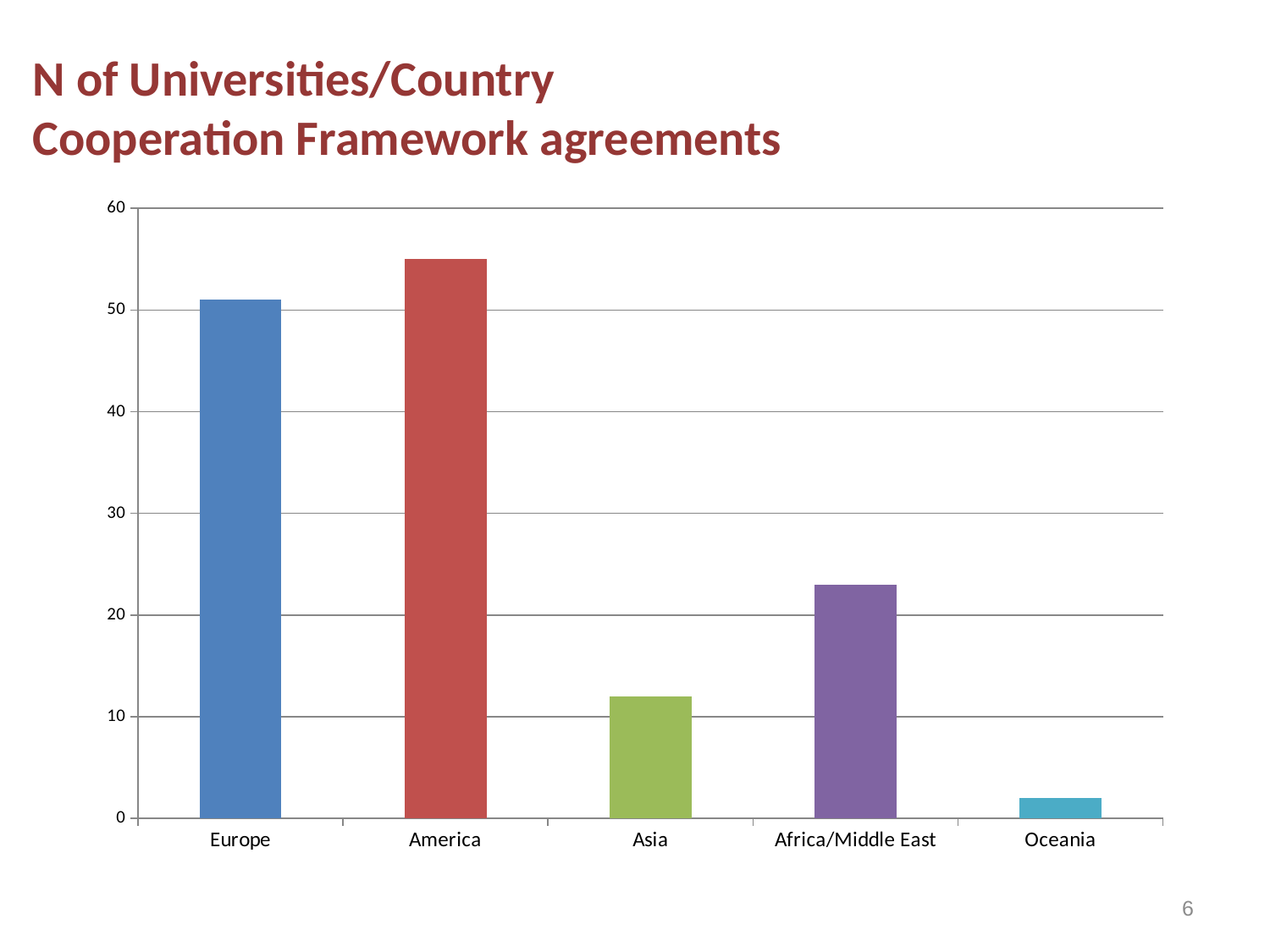
What is the maximum value shown on the y axis of the chart? 60 Which is larger, the value for Asia or the value for Africa/Middle East? Africa/Middle East Is the value for Africa/Middle East greater or less than 20? greater Is the value for Asia greater or less than 20? less How many categories are shown on the x axis of the chart? 5 Is the value for America greater or less than 50? greater Which category has the lowest bar in the chart? Oceania What kind of chart is shown on the slide? bar chart Which is larger, the value for Europe or the value for Asia? Europe Which category has the highest bar in the chart? America